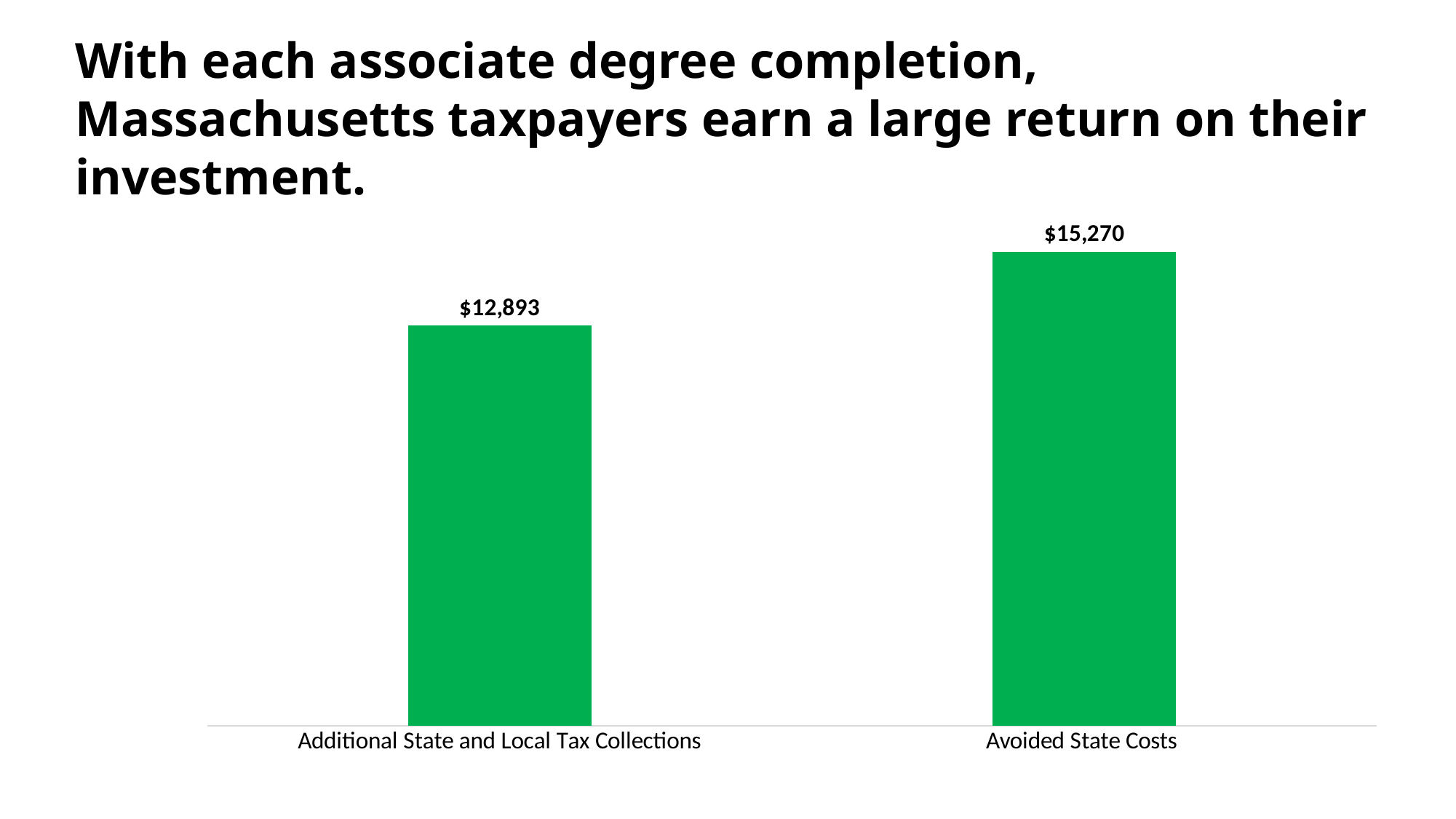
Which category has the highest value? Avoided State Costs What is the total of the two values shown in the chart? $28,163 What is the difference between the value for Avoided State Costs and the value for Additional State and Local Tax Collections? $2,377 What colour are the bars in the chart? Green Which category has the lowest value? Additional State and Local Tax Collections What kind of chart is shown on the slide? Bar chart What is the value for Additional State and Local Tax Collections? $12,893 Which is larger: Additional State and Local Tax Collections or Avoided State Costs? Avoided State Costs What is the value for Avoided State Costs? $15,270 How many categories are shown in the chart? 2 Do the values rise or fall from left to right across the categories? Rise